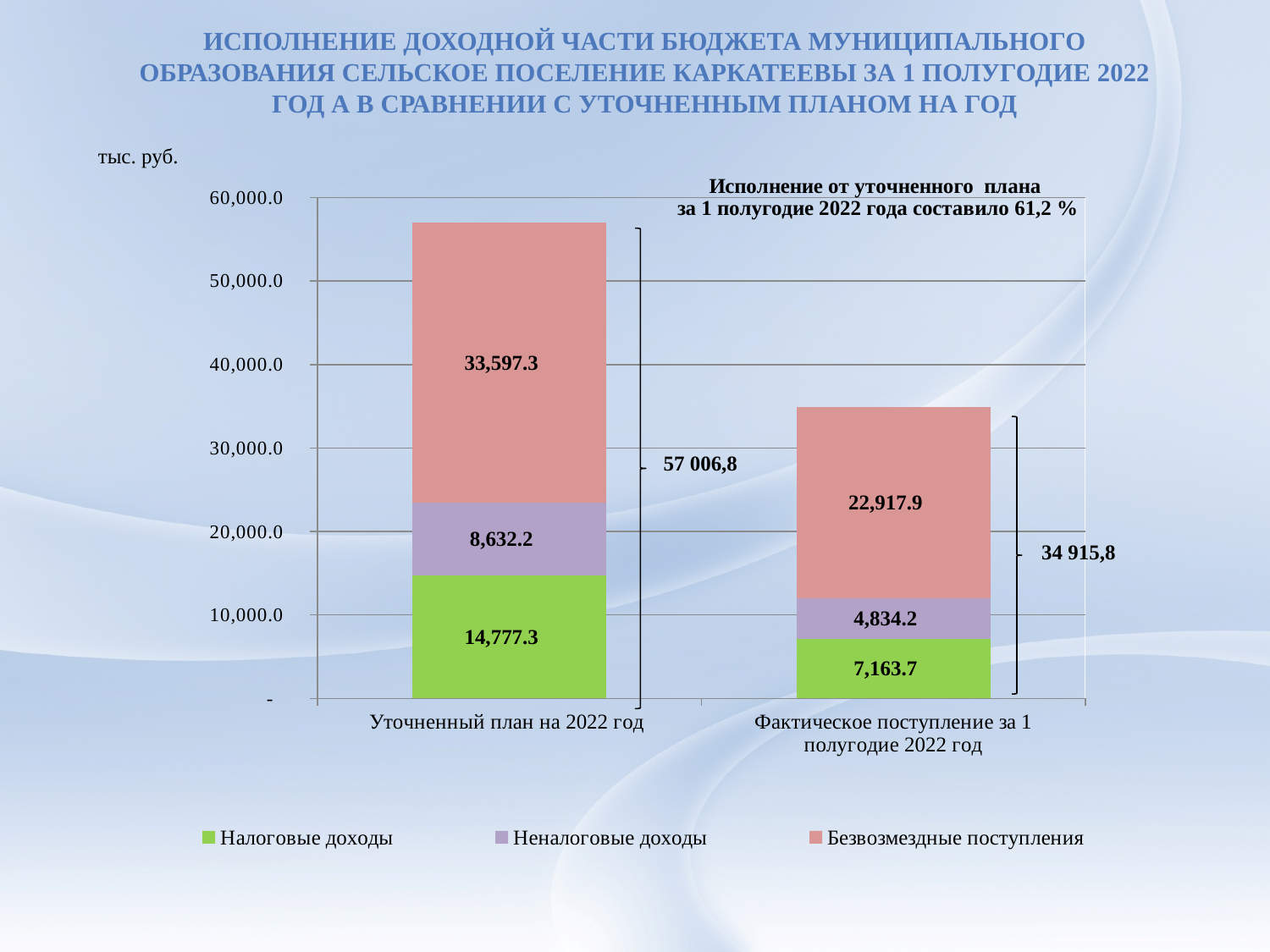
What is the total of the stacked bar for Уточненный план на 2022 год? 57 006,8 What is the value of Безвозмездные поступления for Уточненный план на 2022 год? 33,597.3 How many series does the legend list? 3 Which is larger: Налоговые доходы for Уточненный план на 2022 год or Налоговые доходы for Фактическое поступление за 1 полугодие 2022 год? Уточненный план на 2022 год What type of chart is shown on the slide? Stacked bar chart What is the difference between Безвозмездные поступления for Уточненный план на 2022 год and for Фактическое поступление за 1 полугодие 2022 год? 10,679.4 Which series has the largest value in the Фактическое поступление за 1 полугодие 2022 год bar? Безвозмездные поступления What is the total of the stacked bar for Фактическое поступление за 1 полугодие 2022 год? 34 915,8 What is the value of Налоговые доходы for Уточненный план на 2022 год? 14,777.3 What is the value of Неналоговые доходы for Фактическое поступление за 1 полугодие 2022 год? 4,834.2 What colour represents Неналоговые доходы in the chart? Purple How many categories are shown on the x axis? 2